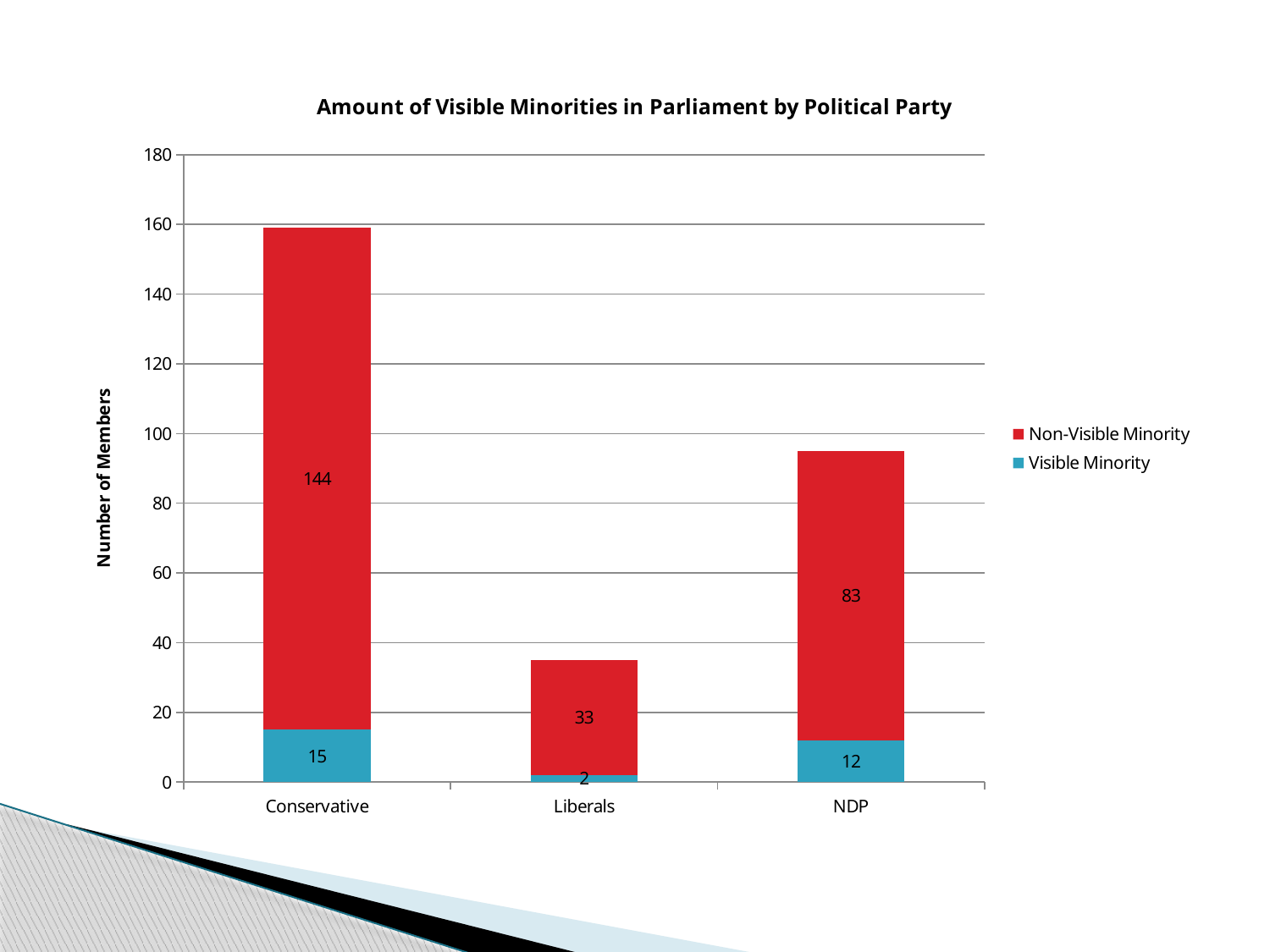
What kind of chart is shown on the slide? Stacked bar chart Which party has the highest Non-Visible Minority value? Conservative What is the total of the stacked bar for Liberals? 35 What is the difference between the Non-Visible Minority values for Conservative and NDP? 61 How many political parties are shown on the x axis? 3 What is the total of the stacked bar for NDP? 95 What is the Visible Minority value for Liberals? 2 Which party has the lowest Visible Minority value? Liberals What is the Visible Minority value for NDP? 12 What is the Non-Visible Minority value for Conservative? 144 Which is larger: the Visible Minority value for Conservative or for NDP? Conservative How many series does the legend list? 2